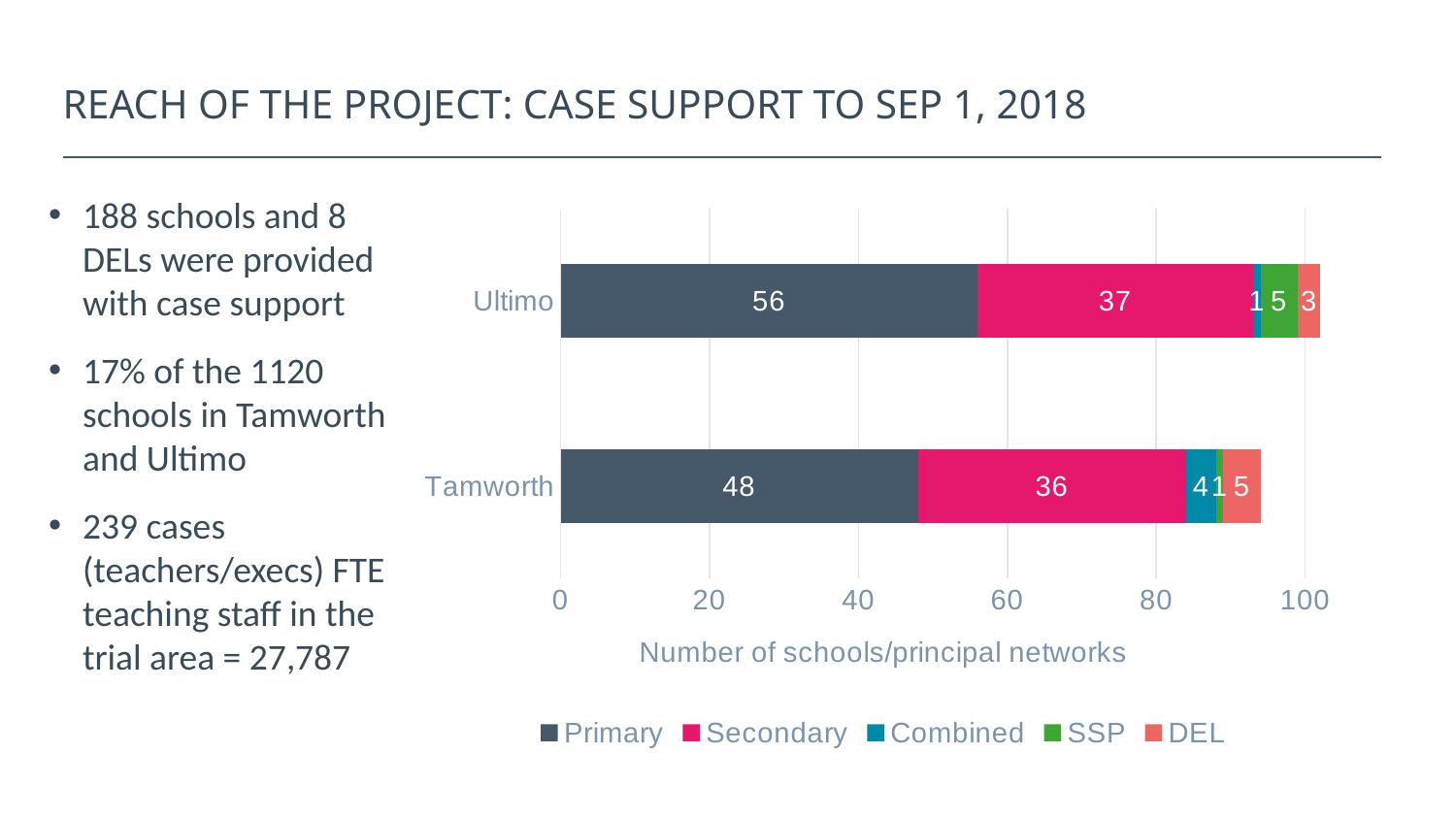
Which category has the higher Primary value, Ultimo or Tamworth? Ultimo What is the total of the stacked bar for Ultimo? 102 What is the SSP value for Ultimo? 5 What is the DEL value for Tamworth? 5 How many series does the legend list? 5 What is the Secondary value for Tamworth? 36 How many categories are shown on the chart? 2 What is the difference between the Primary values for Ultimo and Tamworth? 8 What kind of chart is shown on the slide? Stacked bar chart What is the x-axis title of the chart? Number of schools/principal networks What is the total of the stacked bar for Tamworth? 94 What is the Primary value for Ultimo? 56